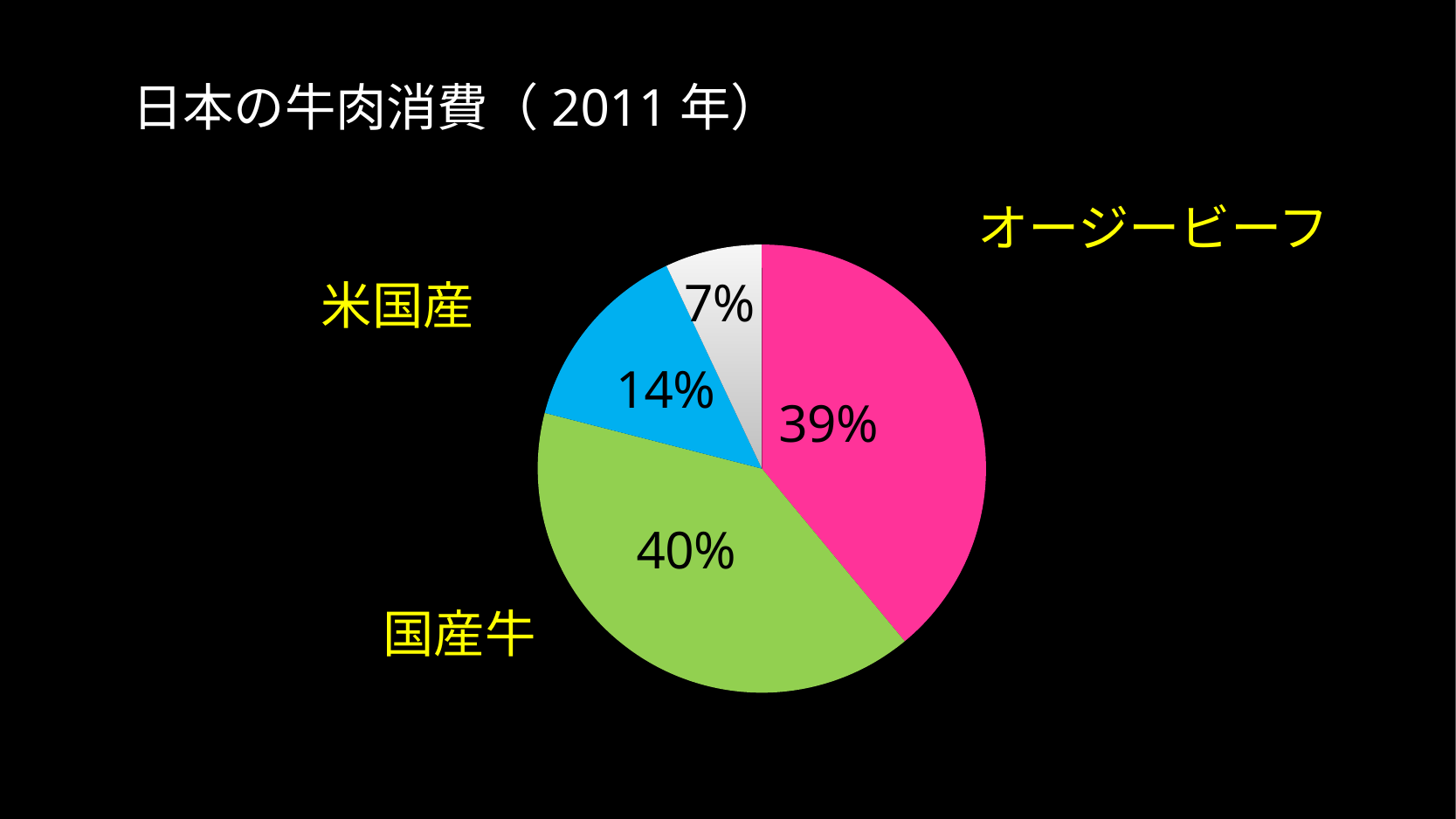
What is the difference in percentage points between 国産牛 and 米国産? 26 Which is larger, the slice for 米国産 or the slice for オージービーフ? オージービーフ What share of the pie does オージービーフ account for? 39% How many slices does the pie chart have? 4 What is the smallest percentage shown on the pie chart? 7% What percentage is shown for 国産牛? 40% Which is larger, the slice for 国産牛 or the slice for オージービーフ? 国産牛 Which labelled category has the largest slice of the pie? 国産牛 What percentage is shown for 米国産? 14% What is the difference in percentage points between オージービーフ and 米国産? 25 What kind of chart is shown on the slide? Pie chart What is the title of the chart on the slide? 日本の牛肉消費（2011年）